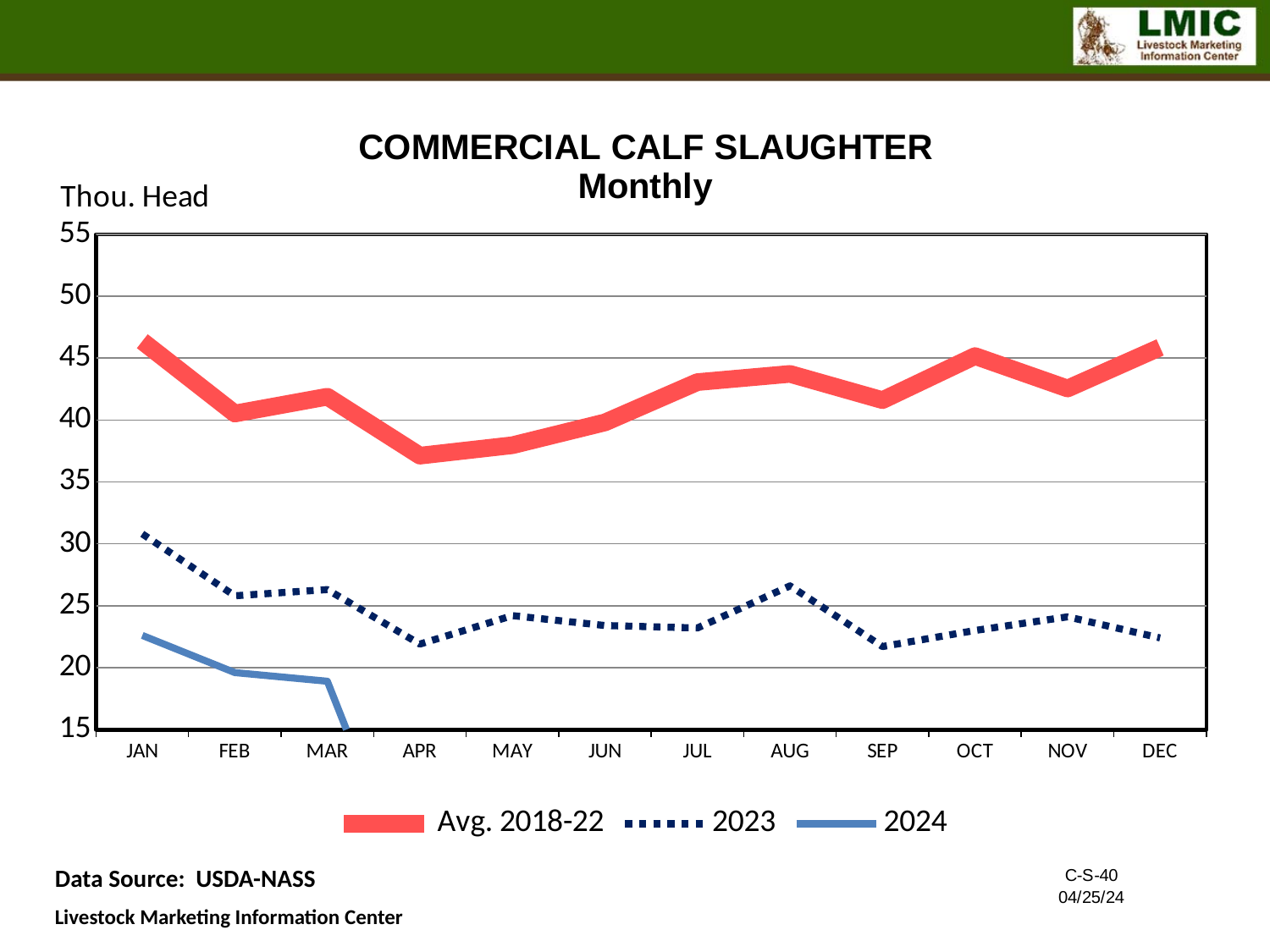
How many months are shown along the x axis? 12 Does the 2024 series rise or fall from JAN to MAR? fall Is the 2024 value for JAN greater or less than 20? greater How many series does the legend list? 3 What kind of chart is shown on the slide? line chart Is the Avg. 2018-22 value for APR greater or less than 40? less What unit label is shown above the y axis? Thou. Head In which month is the 2023 series at its highest? JAN Is the 2023 value for APR greater or less than 25? less For the 2023 series, which month has the larger value: AUG or SEP? AUG In which month is the Avg. 2018-22 series at its lowest? APR In JAN, which series is larger: Avg. 2018-22 or 2023? Avg. 2018-22